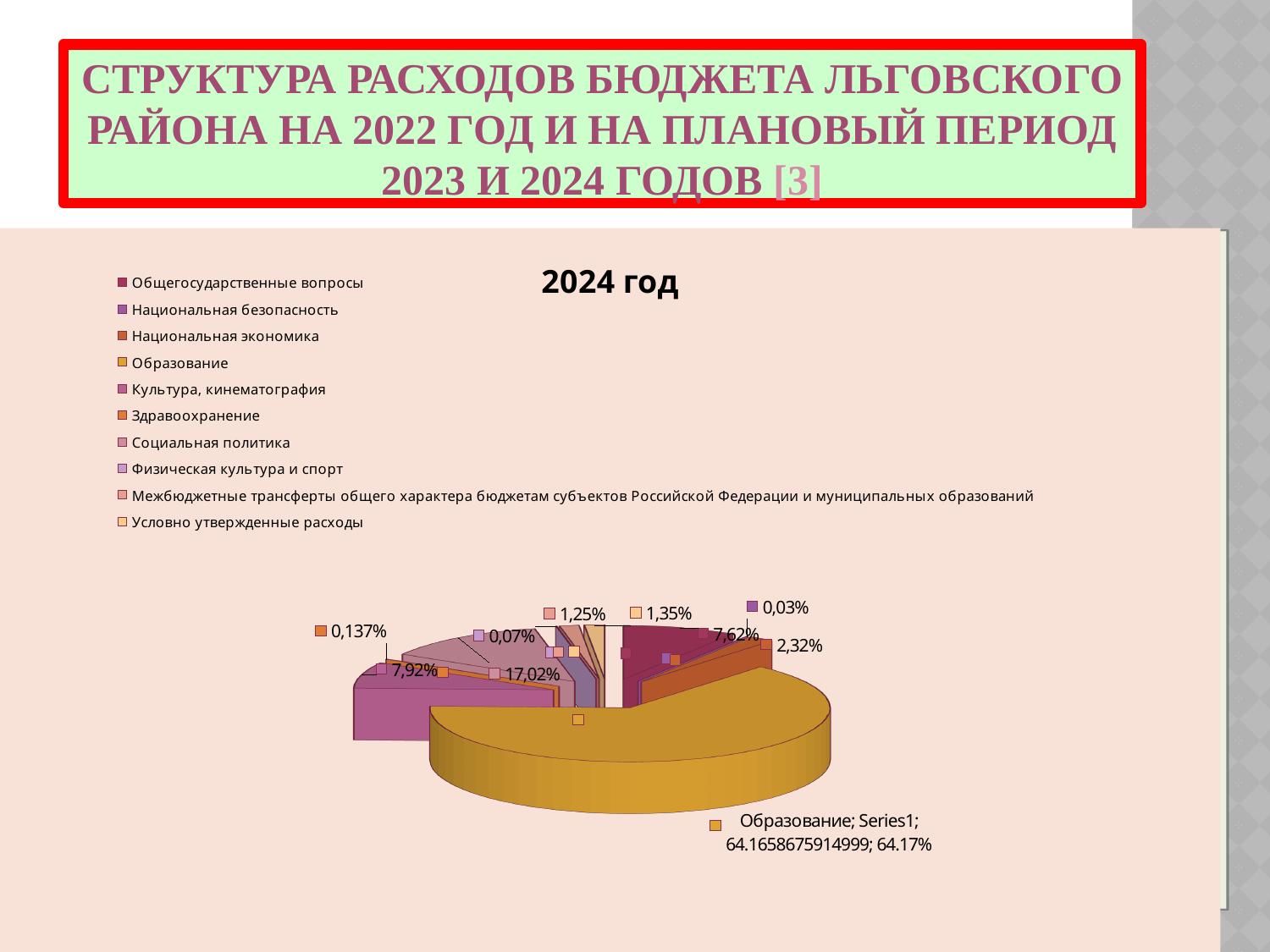
What share of the pie does Образование have? 64.17% Which category is listed first in the legend of the pie chart? Общегосударственные вопросы How many categories does the legend of the pie chart list? 10 Is the share for Образование greater or less than 50%? greater What is the title of the pie chart? 2024 год What is the smallest percentage value printed as a data label on the pie chart? 0,03% What is the largest percentage value printed as a data label on the pie chart? 64.17% Does Образование account for more or less than half of the pie? more Which category has the largest slice of the pie? Образование What kind of chart is shown on the slide? pie chart How many data labels on the pie chart show values below 1%? 3